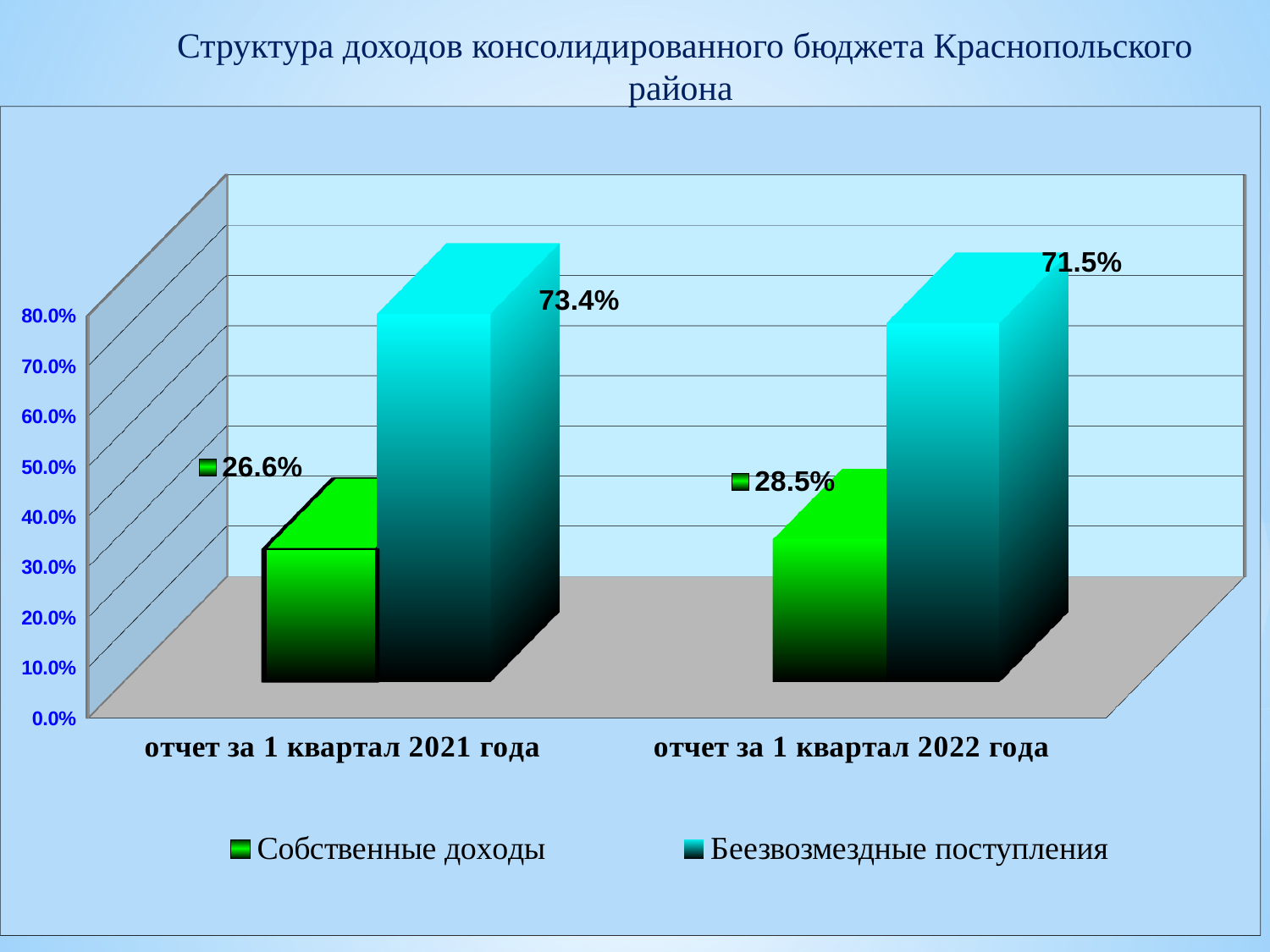
Does the value of Беезвозмездные поступления rise or fall from отчет за 1 квартал 2021 года to отчет за 1 квартал 2022 года? fall What is the value of Беезвозмездные поступления for отчет за 1 квартал 2021 года? 73.4% How many series does the legend list? 2 By how much did Собственные доходы change from отчет за 1 квартал 2021 года to отчет за 1 квартал 2022 года? 1.9% What is the value of Собственные доходы for отчет за 1 квартал 2022 года? 28.5% What is the value of Беезвозмездные поступления for отчет за 1 квартал 2022 года? 71.5% How many categories are shown on the x axis? 2 What is the difference between Беезвозмездные поступления and Собственные доходы for отчет за 1 квартал 2021 года? 46.8% Does the value of Собственные доходы rise or fall from отчет за 1 квартал 2021 года to отчет за 1 квартал 2022 года? rise Which series has the higher value for отчет за 1 квартал 2022 года? Беезвозмездные поступления What is the value of Собственные доходы for отчет за 1 квартал 2021 года? 26.6% What kind of chart is shown on the slide? bar chart